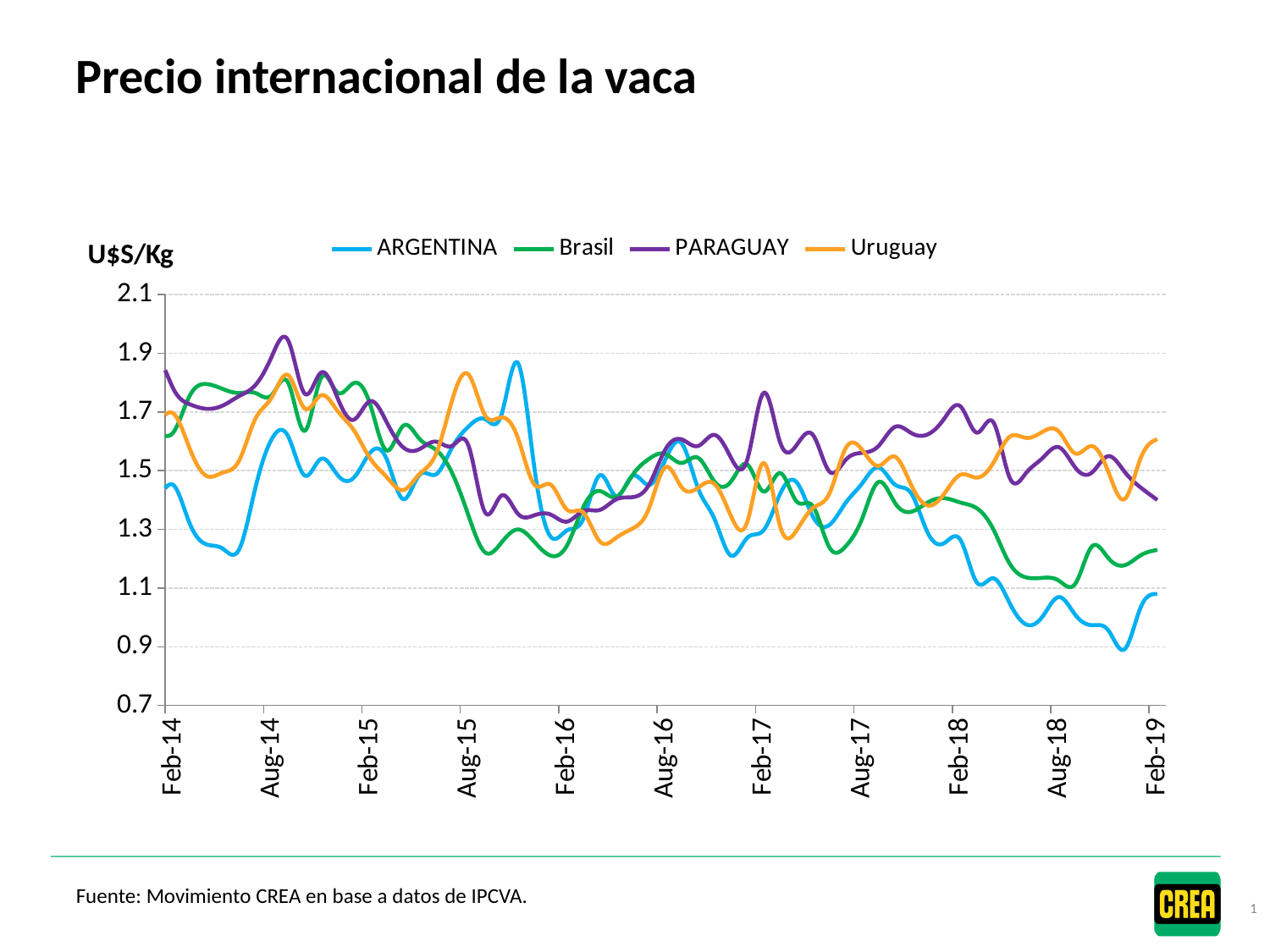
How many series does the legend list? 4 Is the lowest value reached by ARGENTINA (late 2018) greater or less than 1.1? less Which series has the highest value at Feb-19? Uruguay What is the title of the chart? Precio internacional de la vaca Is the value for ARGENTINA at Feb-19 greater or less than 1.3? less What unit is shown for the vertical axis? U$S/Kg Does the ARGENTINA series rise or fall overall between Feb-17 and Feb-19? fall What kind of chart is shown on the slide? line chart Is the value for Uruguay at Feb-19 greater or less than 1.5? greater Which series has the lowest value at Feb-19? ARGENTINA